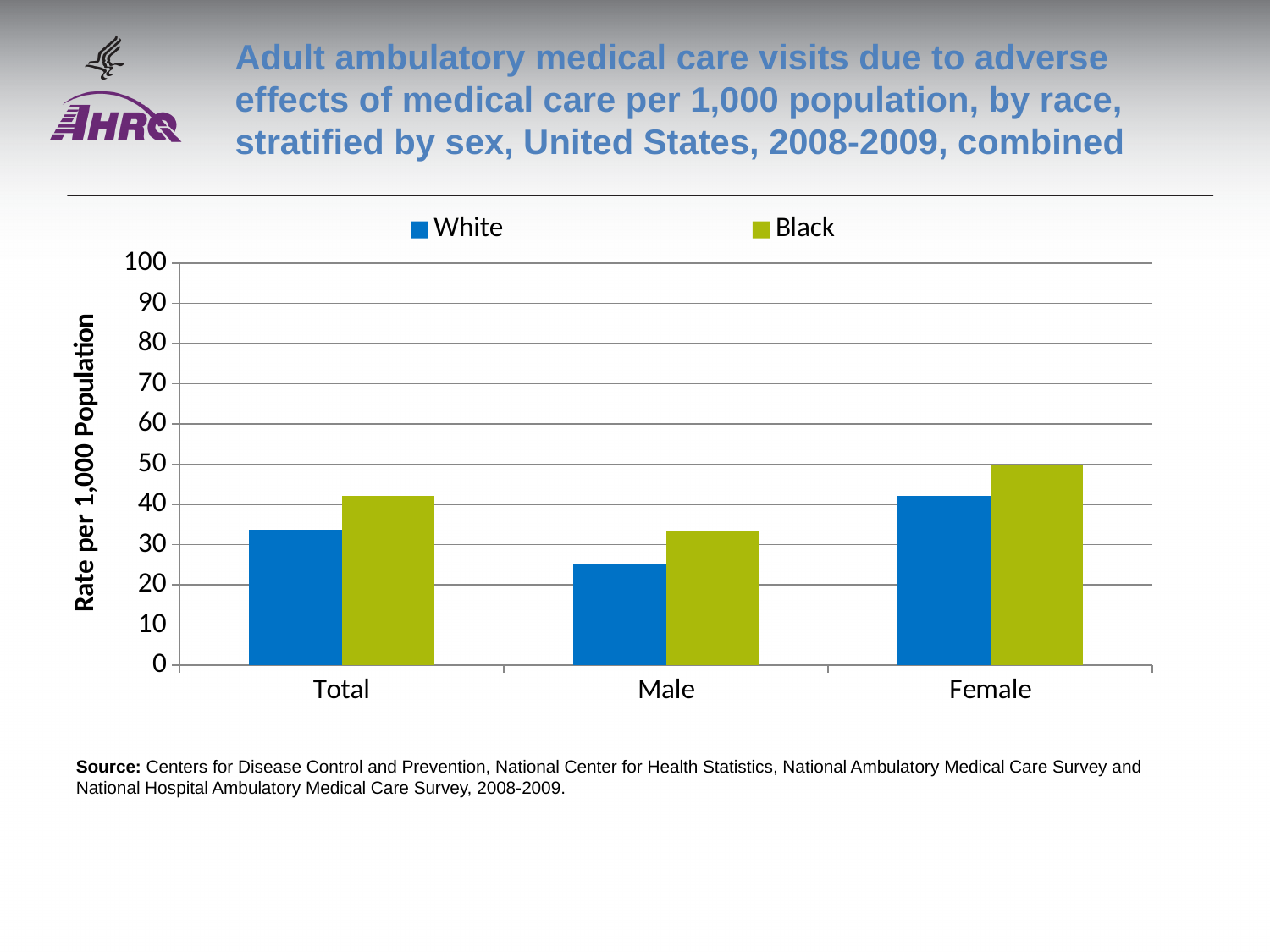
What is the label of the y axis? Rate per 1,000 Population Which category has the lowest White rate? Male Is the value for Black in the Female category greater or less than 40? greater Is the value for Black in the Male category greater or less than 40? less In the Total category, which is larger, the White rate or the Black rate? Black Is the Black rate for Female larger or smaller than the Black rate for Male? larger Is the value for White in the Total category greater or less than 30? greater How many series does the legend list? 2 What kind of chart is shown on the slide? bar chart Which category has the highest Black rate? Female How many categories are shown on the x axis? 3